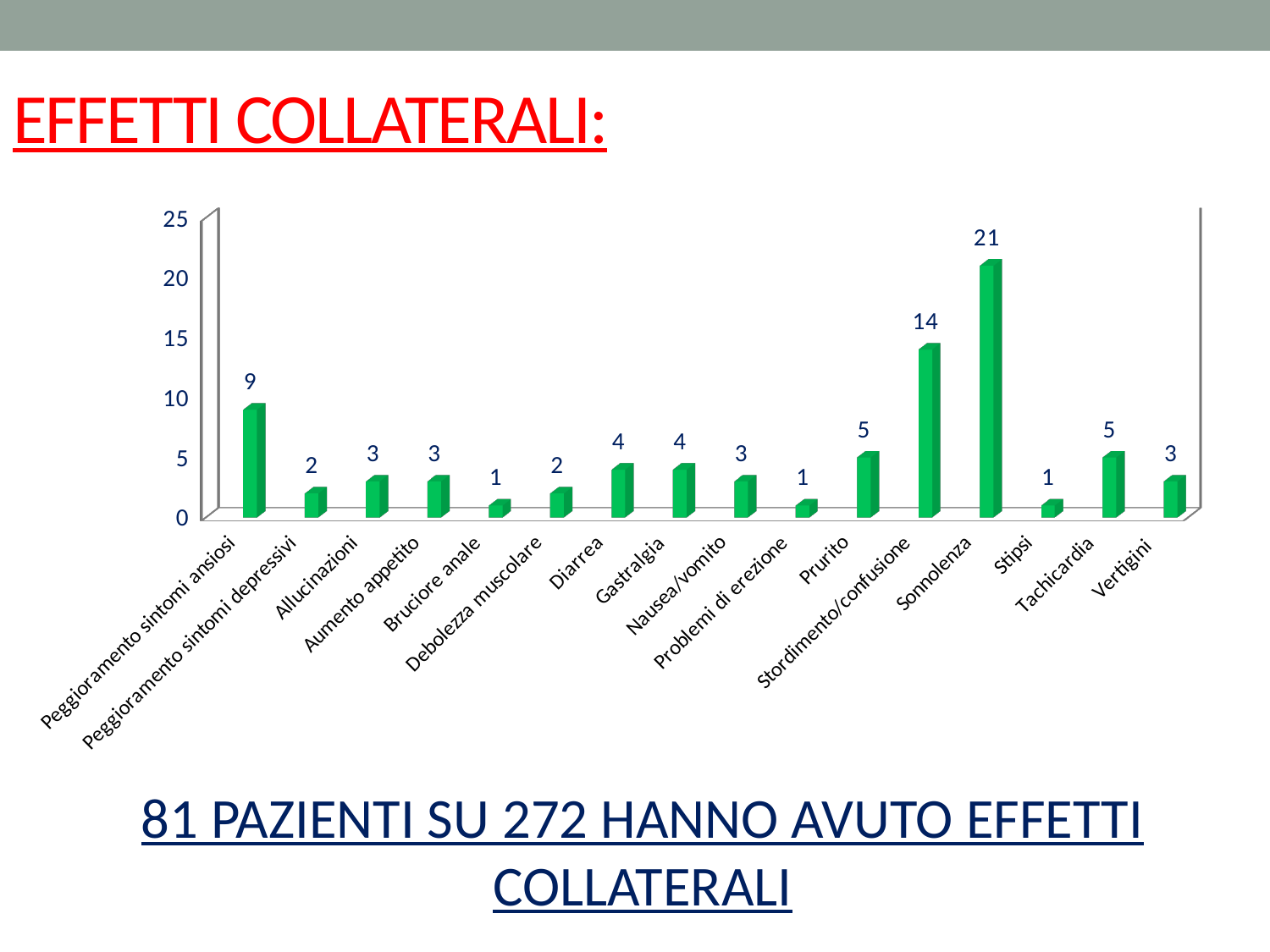
What is the difference between the values for Peggioramento sintomi ansiosi and Prurito? 4 What is the title of the slide above the chart? EFFETTI COLLATERALI: What is the value for Stordimento/confusione? 14 Is the value for Stordimento/confusione greater or less than 10? greater Which category has the highest value? Sonnolenza How many categories are shown on the x axis? 16 What is the value for Tachicardia? 5 Which is larger, the value for Diarrea or the value for Nausea/vomito? Diarrea What kind of chart is shown on the slide? Bar chart What is the difference between the values for Sonnolenza and Stordimento/confusione? 7 What is the value for Sonnolenza? 21 What is the value for Peggioramento sintomi ansiosi? 9